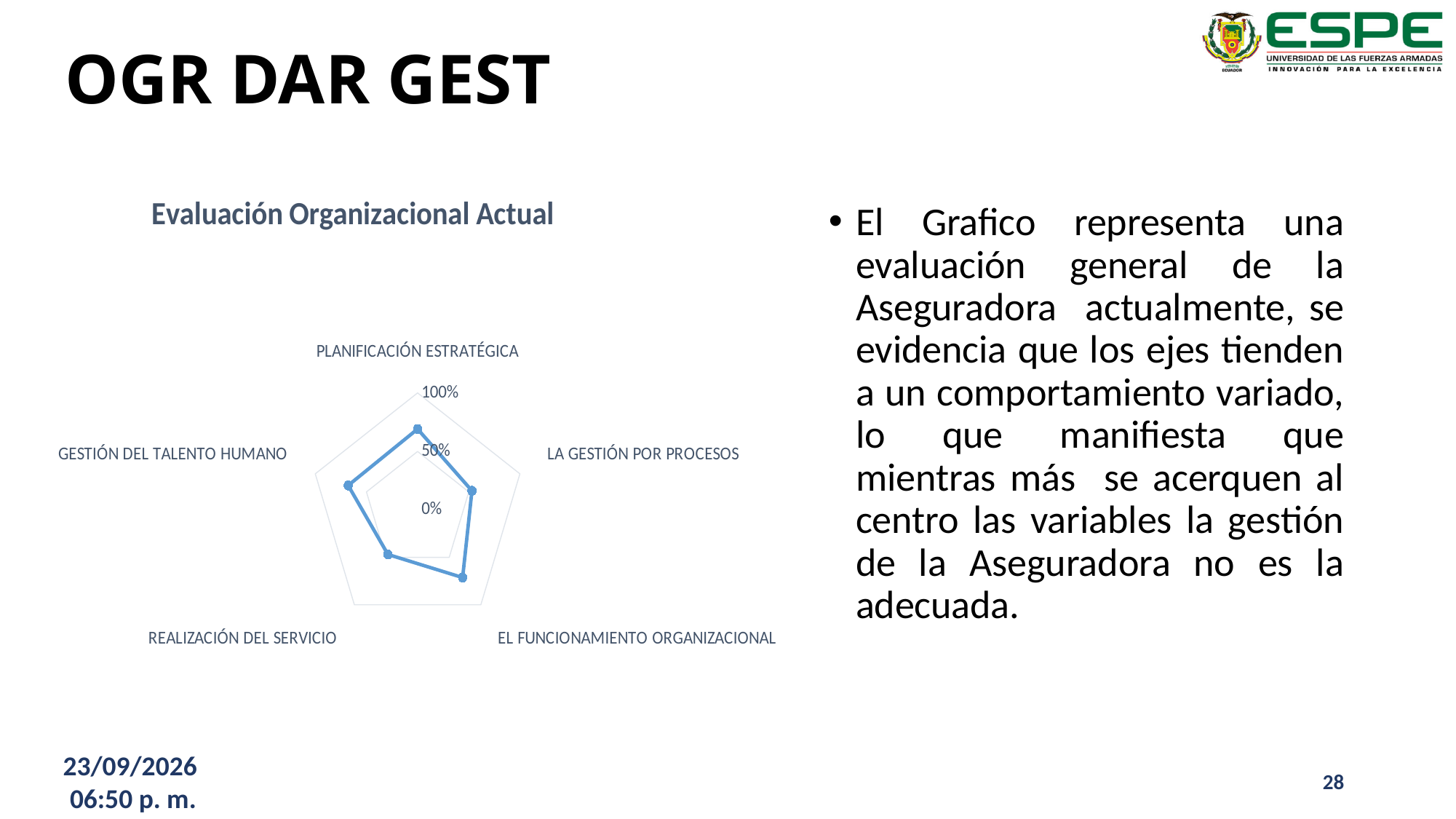
Is the value for GESTIÓN DEL TALENTO HUMANO greater or less than 100%? less What is the title of the chart? Evaluación Organizacional Actual Which is larger, the value for GESTIÓN DEL TALENTO HUMANO or the value for LA GESTIÓN POR PROCESOS? GESTIÓN DEL TALENTO HUMANO Which category has the lowest value on the radar chart? REALIZACIÓN DEL SERVICIO Is the value for PLANIFICACIÓN ESTRATÉGICA greater or less than 50%? greater How many data series are plotted on the radar chart? 1 Is the value for EL FUNCIONAMIENTO ORGANIZACIONAL greater or less than 50%? greater What kind of chart is shown on the slide? Radar chart Which is larger, the value for PLANIFICACIÓN ESTRATÉGICA or the value for LA GESTIÓN POR PROCESOS? PLANIFICACIÓN ESTRATÉGICA How many categories (axes) does the radar chart have? 5 What is the maximum value shown on the radar chart's axis scale? 100%